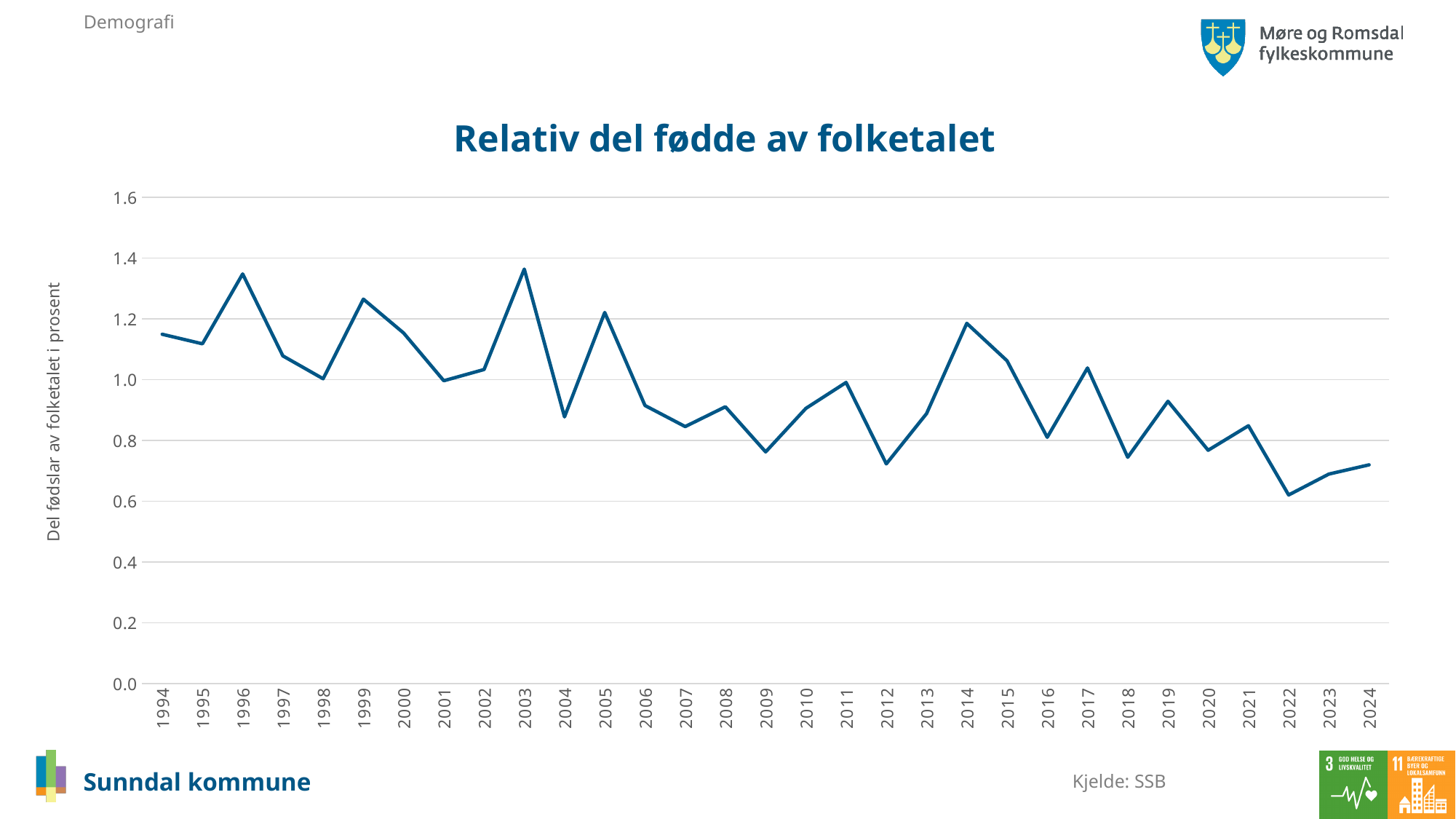
Is the value for 1996 greater or less than 1.2? greater Which year has the larger value, 1996 or 2022? 1996 What is the title of the chart? Relativ del fødde av folketalet What kind of chart is shown on the slide? line chart Is the value for 2022 greater or less than 0.8? less Is the value for 2014 greater or less than 1.0? greater How many years are plotted along the x axis of the chart? 31 Which year has the larger value, 2004 or 2005? 2005 Which year has the lowest value in the chart? 2022 Overall, do the values rise or fall from 1994 to 2024? fall What is the label on the vertical axis of the chart? Del fødslar av folketalet i prosent